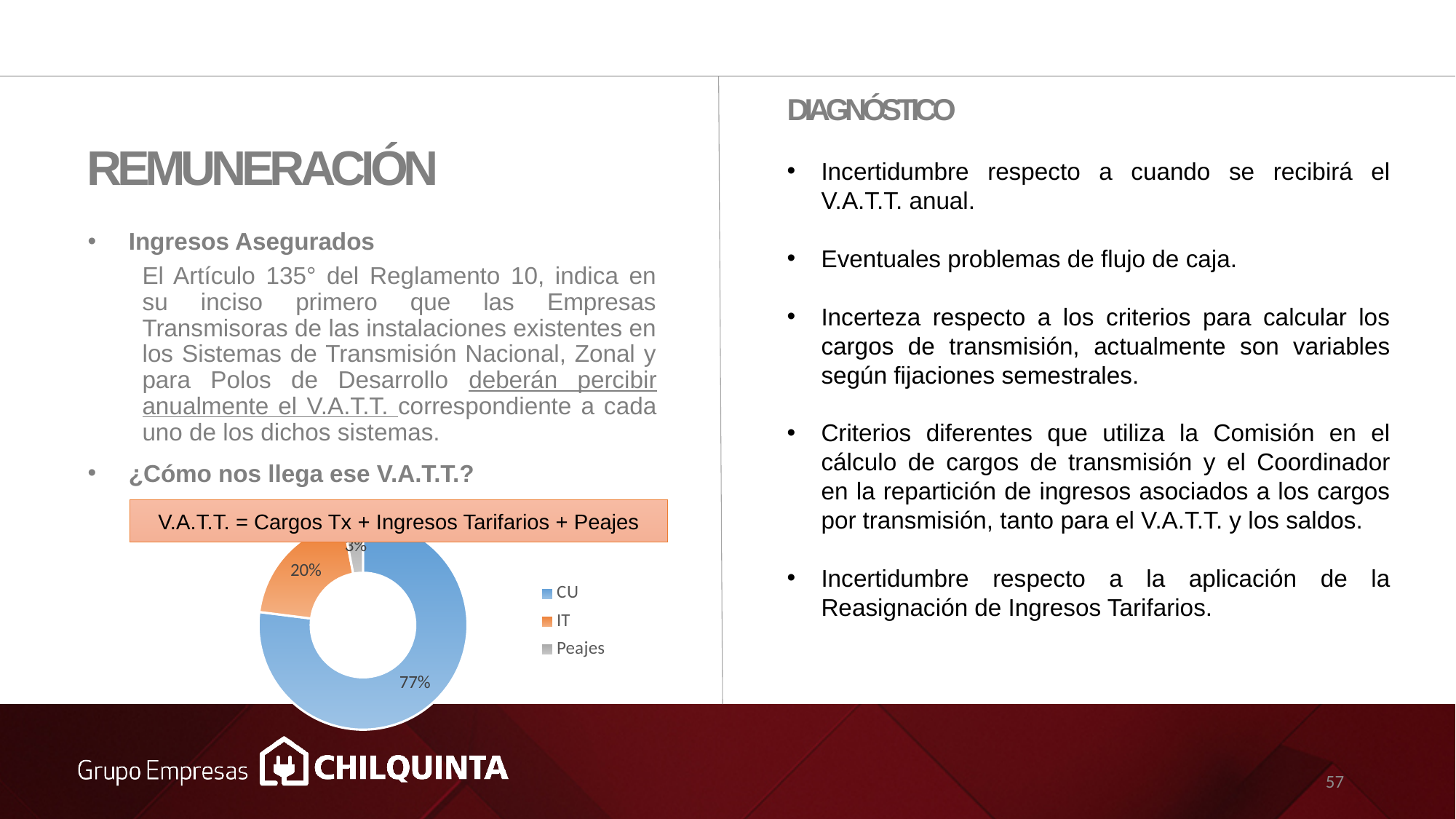
Which category has the smallest share in the donut chart? Peajes How many entries does the legend of the donut chart list? 3 What share of the donut chart does IT represent? 20% What share of the donut chart does Peajes represent? 3% Which is larger in the donut chart, CU or IT? CU How many categories are shown in the donut chart? 3 What colour represents IT in the donut chart? orange What colour represents CU in the donut chart? blue What share of the donut chart does CU represent? 77% Which category has the largest share in the donut chart? CU What is the difference between the CU share and the IT share in the donut chart? 57% What kind of chart is shown on the slide? donut chart